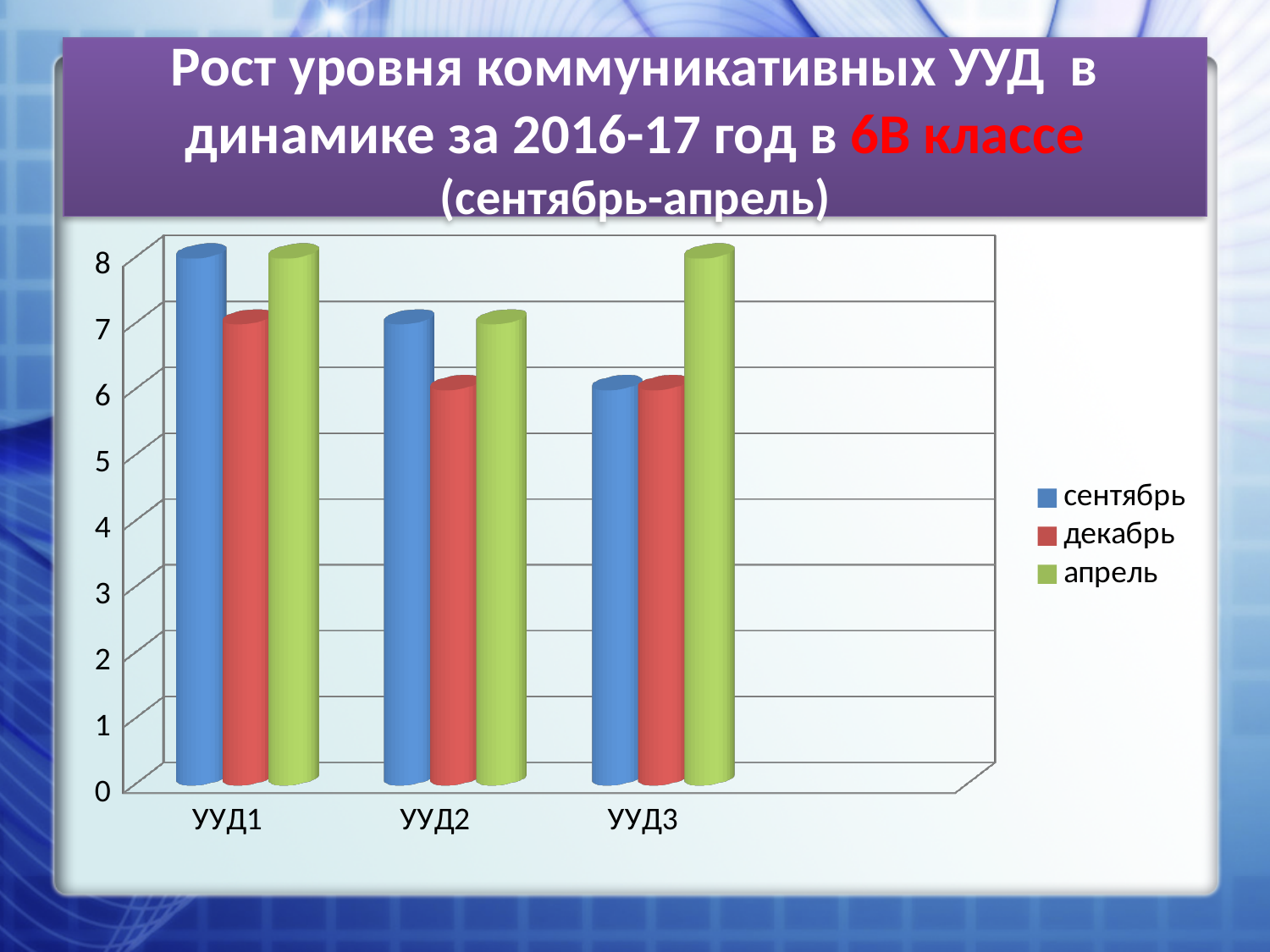
Which series does the green bar represent? апрель What is the value for апрель in УУД3? 8 What kind of chart is shown on the slide? bar chart What is the value for сентябрь in УУД1? 8 How many series does the legend list? 3 Which category has the highest value for декабрь? УУД1 What is the difference between the апрель value and the декабрь value in УУД3? 2 How many categories are shown on the x axis? 3 Is the value for апрель in УУД2 greater or less than 5? greater What is the value for декабрь in УУД2? 6 Which category has the lowest value for сентябрь? УУД3 Which is larger in УУД3: the value for сентябрь or the value for апрель? апрель